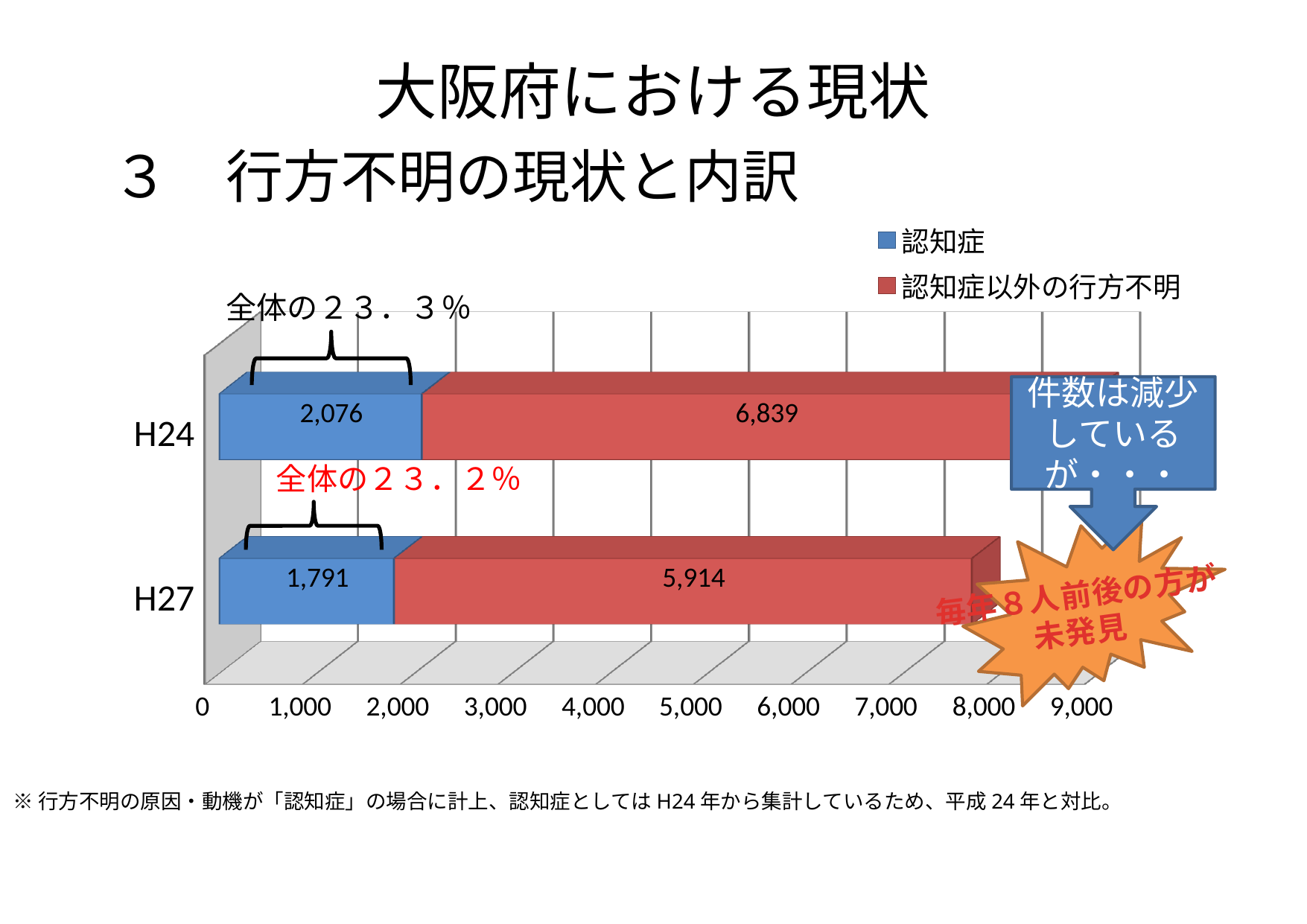
What is the value of 認知症以外の行方不明 for H27? 5,914 What is the value of 認知症 for H27? 1,791 How many categories are shown on the chart? 2 What is the difference between the 認知症 values for H24 and H27? 285 What is the difference between the 認知症以外の行方不明 values for H24 and H27? 925 What is the total of the stacked bar for H27? 7,705 What is the total of the stacked bar for H24? 8,915 How many series does the legend list? 2 What kind of chart is shown on the slide? Stacked bar chart Which year has the higher value for 認知症, H24 or H27? H24 What is the value of 認知症以外の行方不明 for H24? 6,839 What is the value of 認知症 for H24? 2,076